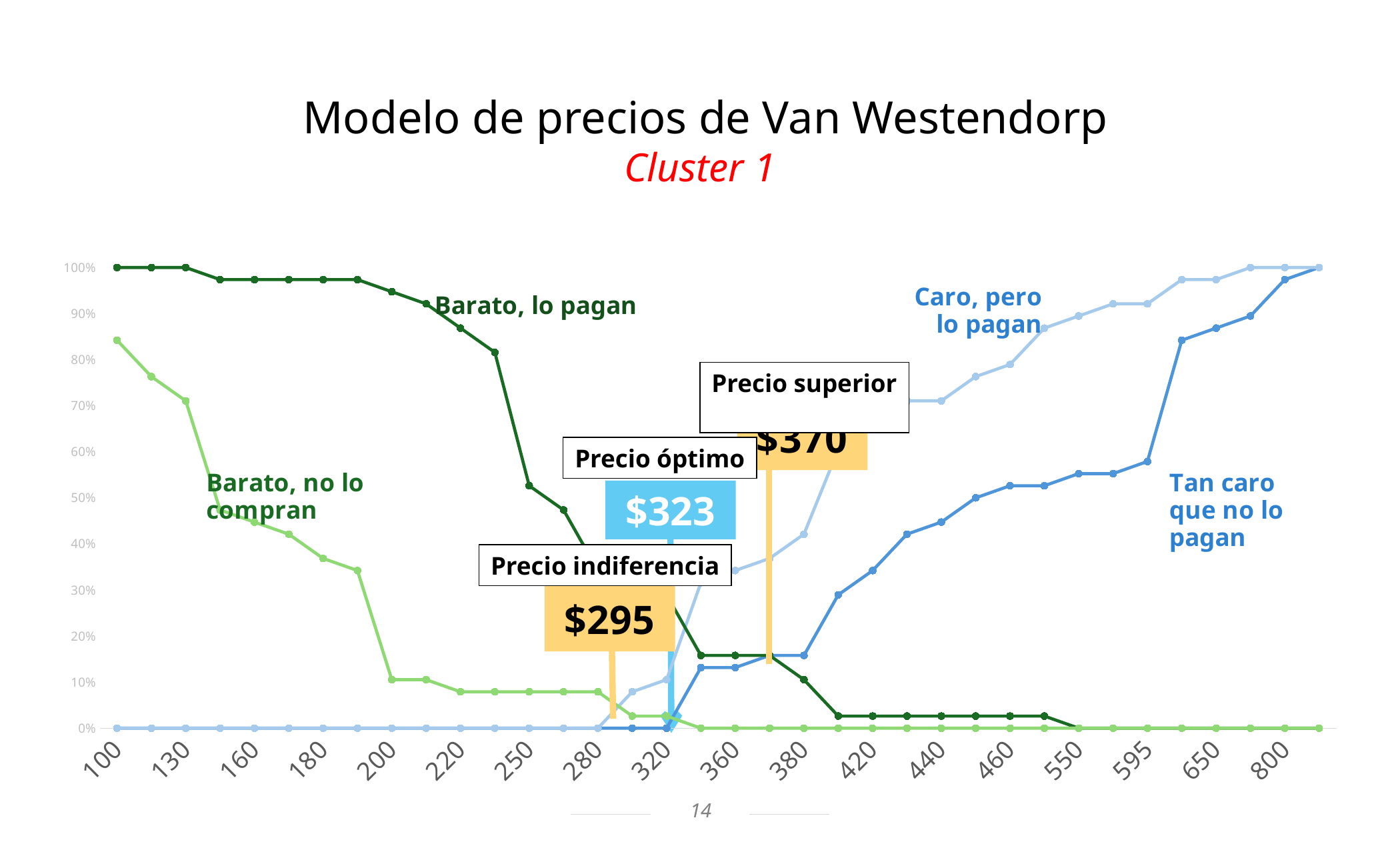
What is the value shown for 'Precio óptimo'? $323 What kind of chart is shown on the slide? line chart What is the value shown for 'Precio indiferencia'? $295 What is the value shown for 'Precio superior'? $370 Does the 'Tan caro que no lo pagan' line rise or fall as the price increases along the x axis? rise At price 440, which line is higher: 'Caro, pero lo pagan' or 'Tan caro que no lo pagan'? Caro, pero lo pagan Is the value of 'Caro, pero lo pagan' at price 460 greater or less than 70%? greater How many data series are plotted on the chart? 4 Is the value of 'Barato, lo pagan' at price 250 greater or less than 70%? less At price 100, which line is higher: 'Barato, lo pagan' or 'Barato, no lo compran'? Barato, lo pagan Is the value of 'Barato, no lo compran' at price 100 greater or less than 80%? greater Does the 'Barato, lo pagan' line rise or fall as the price increases along the x axis? fall